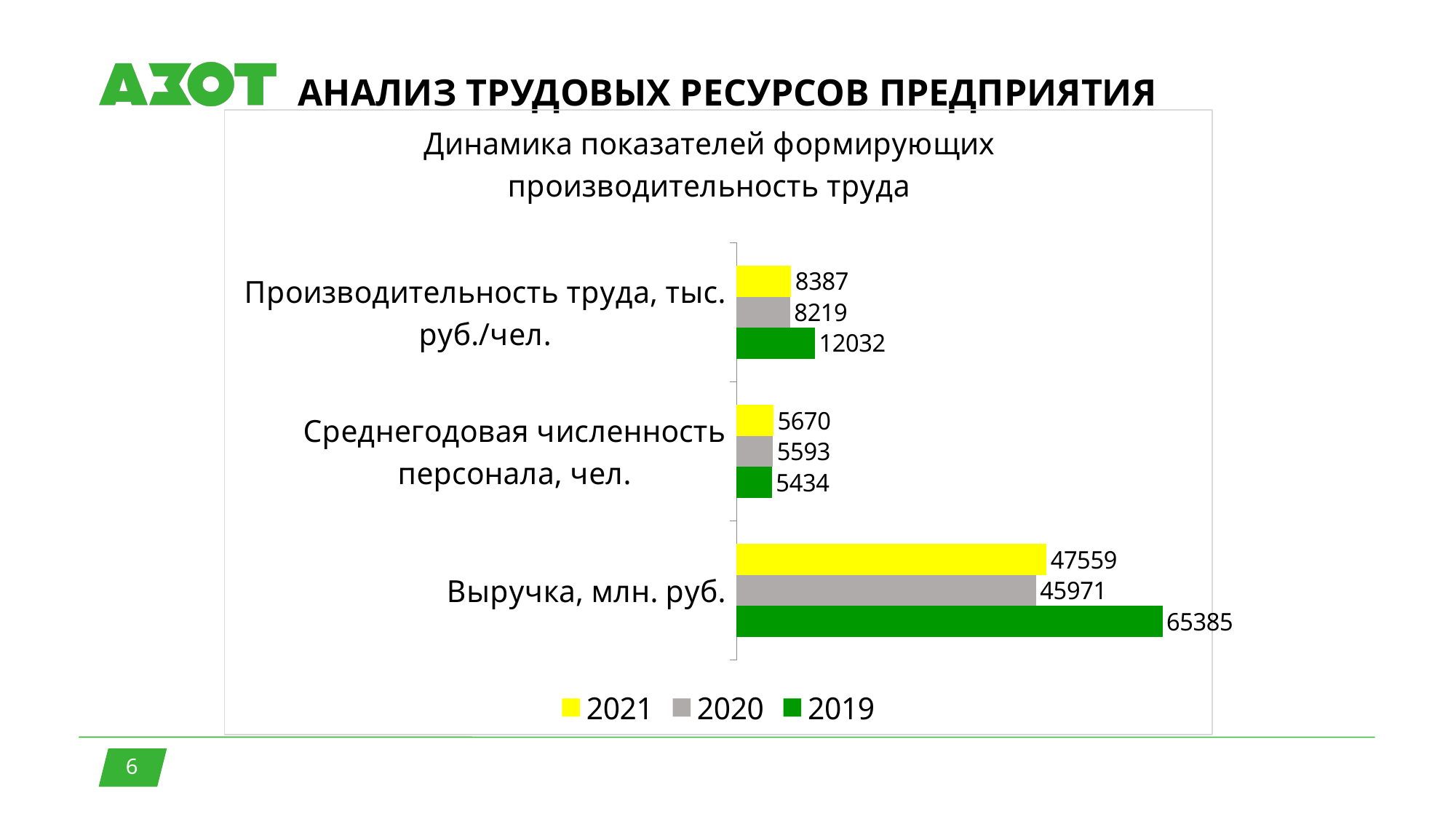
What is the value of Выручка, млн. руб. for 2019? 65385 Which year has the highest value for Выручка, млн. руб.? 2019 What is the difference between the 2021 and 2020 values for Выручка, млн. руб.? 1588 Which colour represents the 2020 series in the chart? Grey Which is larger for Среднегодовая численность персонала, чел.: the 2020 value or the 2019 value? 2020 What kind of chart is shown on the slide? Bar chart How many series does the legend list? 3 What is the value of Среднегодовая численность персонала, чел. for 2021? 5670 Which year has the lowest value for Среднегодовая численность персонала, чел.? 2019 How many categories are shown on the chart? 3 What is the difference between the 2019 and 2021 values for Производительность труда, тыс. руб./чел.? 3645 What is the value of Производительность труда, тыс. руб./чел. for 2020? 8219